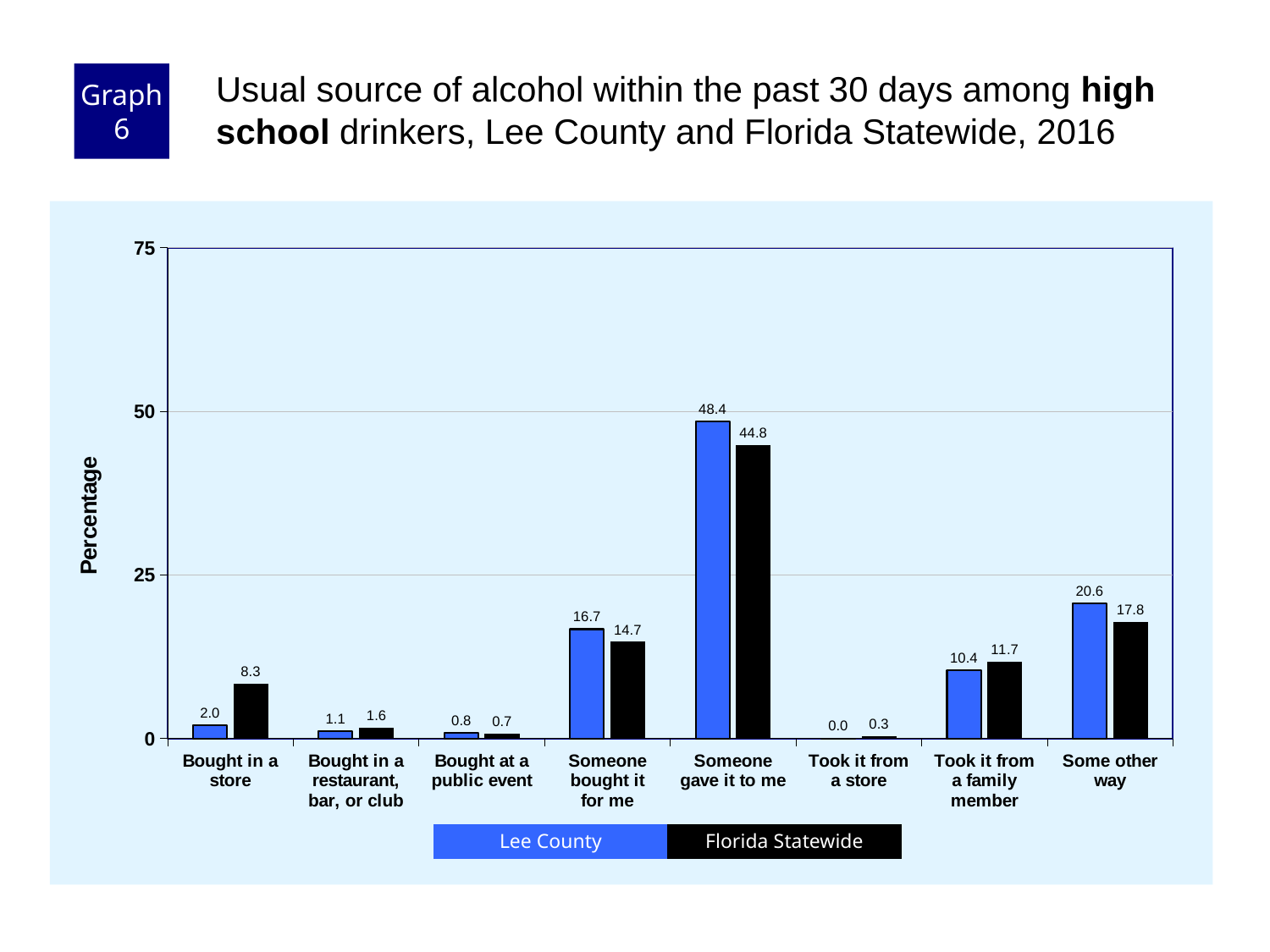
What is the label of the y axis? Percentage For "Someone bought it for me", which is larger: Lee County or Florida Statewide? Lee County Which category has the lowest Lee County value? Took it from a store How many categories are shown on the x axis? 8 What kind of chart is shown on the slide? Bar chart What is the difference between the Lee County and Florida Statewide values for "Some other way"? 2.8 Which category has the highest Florida Statewide value? Someone gave it to me What is the Lee County value for "Someone gave it to me"? 48.4 What is the Florida Statewide value for "Bought in a store"? 8.3 Is the Florida Statewide value for "Someone gave it to me" greater or less than 25? greater What is the Lee County value for "Took it from a family member"? 10.4 How many series does the legend list? 2